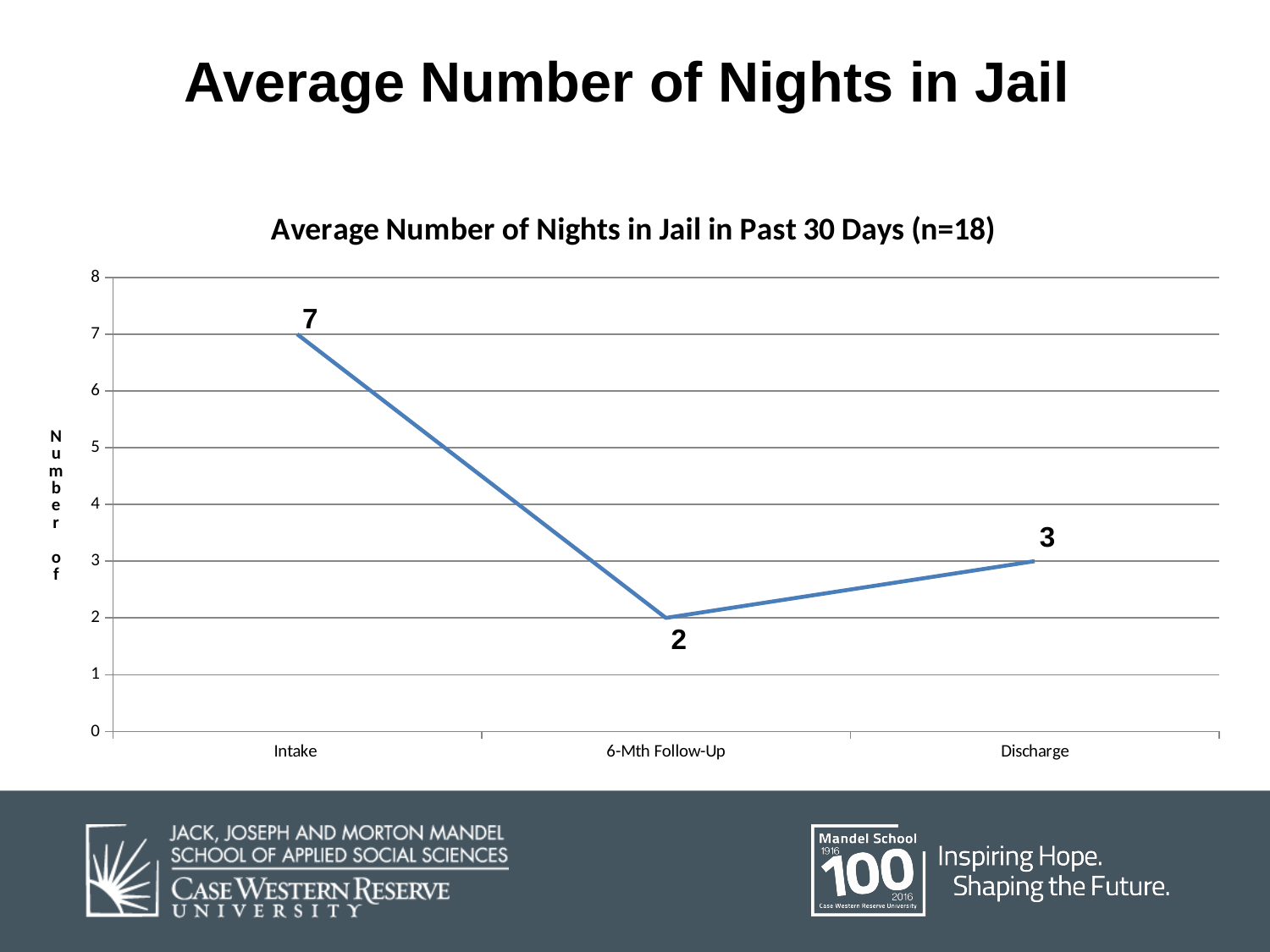
Which time point has the lowest average number of nights in jail? 6-Mth Follow-Up How many time points are plotted on the chart? 3 What is the difference between the value at Intake and the value at 6-Mth Follow-Up? 5 What is the average number of nights in jail at Intake? 7 What is the title of the chart? Average Number of Nights in Jail in Past 30 Days (n=18) What is the average number of nights in jail at 6-Mth Follow-Up? 2 Which time point has the highest average number of nights in jail? Intake What is the average number of nights in jail at Discharge? 3 Which is larger, the value at Intake or the value at Discharge? Intake What is the difference between the value at Discharge and the value at 6-Mth Follow-Up? 1 What kind of chart is shown on the slide? Line chart Is the value at Intake greater or less than 5? greater